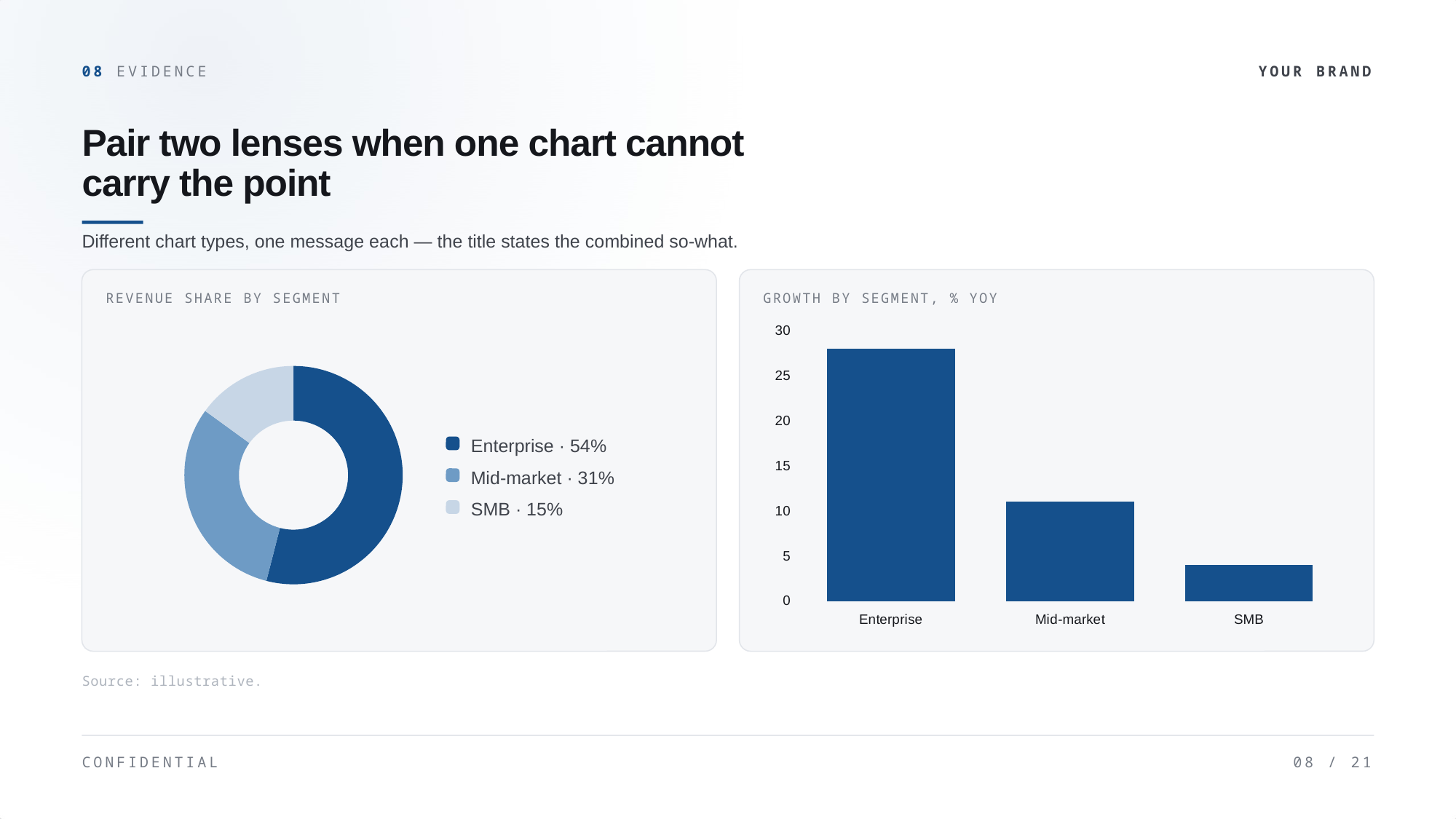
In the 'Revenue share by segment' chart, what share does Mid-market hold? 31% In the 'Growth by segment, % YoY' chart, is the value for SMB greater or less than 5? less In the 'Growth by segment, % YoY' chart, is the value for Enterprise greater or less than 25? greater In the 'Revenue share by segment' chart, which segment has the largest share? Enterprise In the 'Growth by segment, % YoY' chart, which segment has the highest growth? Enterprise In the 'Revenue share by segment' chart, which segment has the smallest share? SMB In the 'Revenue share by segment' chart, what share does SMB hold? 15% What kind of chart is the 'Revenue share by segment' chart? Donut chart In the 'Revenue share by segment' chart, how many segments are shown? 3 In the 'Revenue share by segment' chart, what share does Enterprise hold? 54% What kind of chart is the 'Growth by segment, % YoY' chart? Bar chart In the 'Revenue share by segment' chart, what is the difference between the Enterprise and Mid-market shares? 23%